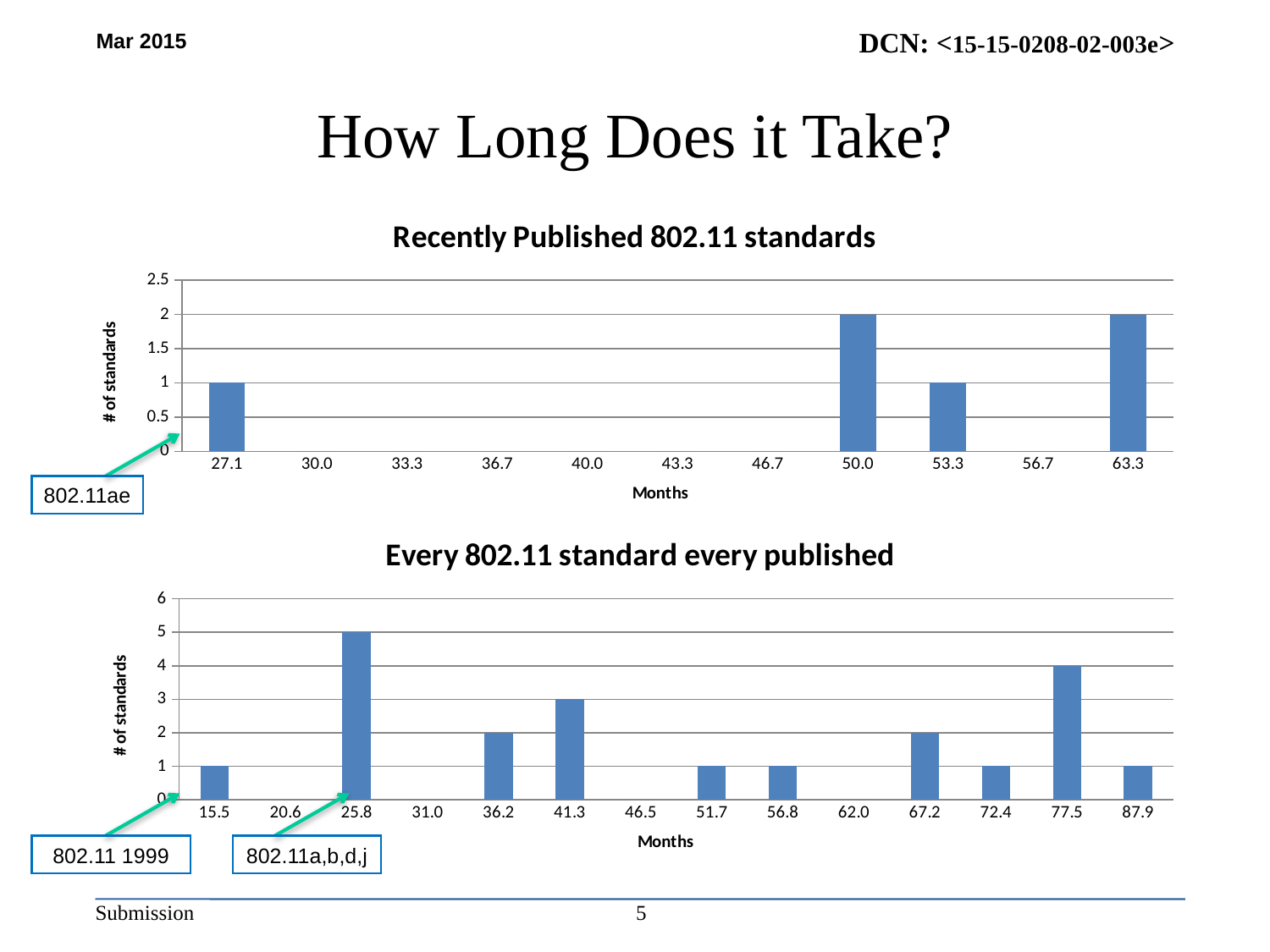
How many months categories are shown on the x axis of the 'Recently Published 802.11 standards' chart? 11 In the 'Every 802.11 standard every published' chart, what is the difference between the number of standards at 25.8 months and at 41.3 months? 2 How many months categories are shown on the x axis of the 'Every 802.11 standard every published' chart? 14 In the 'Recently Published 802.11 standards' chart, what is the number of standards at 50.0 months? 2 In the 'Every 802.11 standard every published' chart, which is larger: the value at 36.2 months or the value at 41.3 months? 41.3 months What is the y-axis label of the 'Every 802.11 standard every published' chart? # of standards In the 'Recently Published 802.11 standards' chart, what is the number of standards at 53.3 months? 1 What type of chart is the 'Recently Published 802.11 standards' chart? Bar chart In the 'Every 802.11 standard every published' chart, what is the number of standards at 25.8 months? 5 In the 'Recently Published 802.11 standards' chart, which is larger: the value at 27.1 months or the value at 63.3 months? 63.3 months In the 'Every 802.11 standard every published' chart, what is the number of standards at 77.5 months? 4 In the 'Every 802.11 standard every published' chart, which months category has the highest number of standards? 25.8